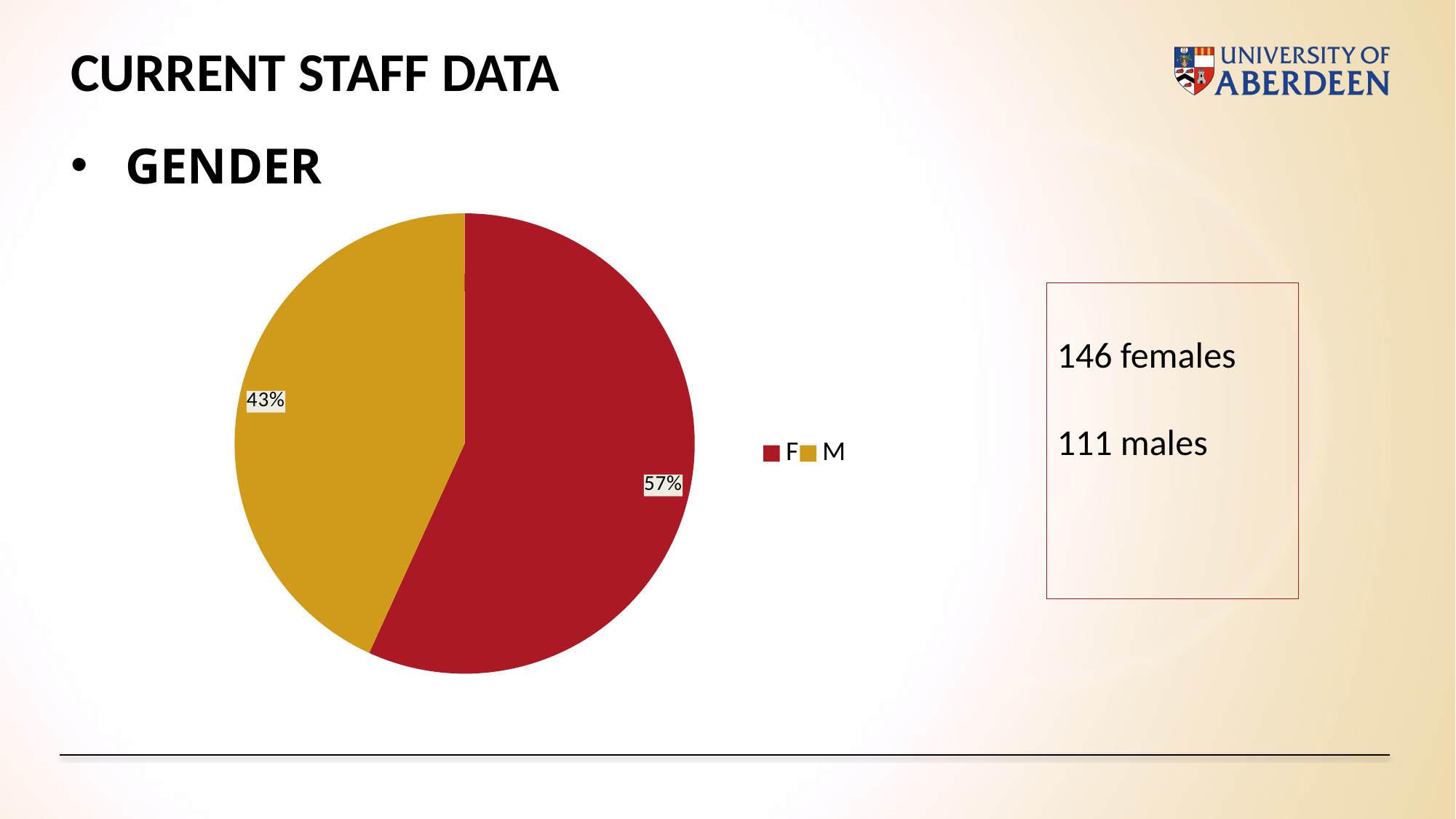
What colour is the M slice in the pie chart? gold Is the share for F greater or less than 50%? greater How many entries does the legend list? 2 What colour is the F slice in the pie chart? red What percentage of the pie is labelled for M? 43% Which slice of the pie is the largest? F How many slices does the pie chart have? 2 What kind of chart is shown on the slide? pie chart Which slice of the pie is the smallest? M What percentage of the pie is labelled for F? 57% What is the difference in percentage points between the F slice and the M slice? 14 Which is larger, the F slice or the M slice? F